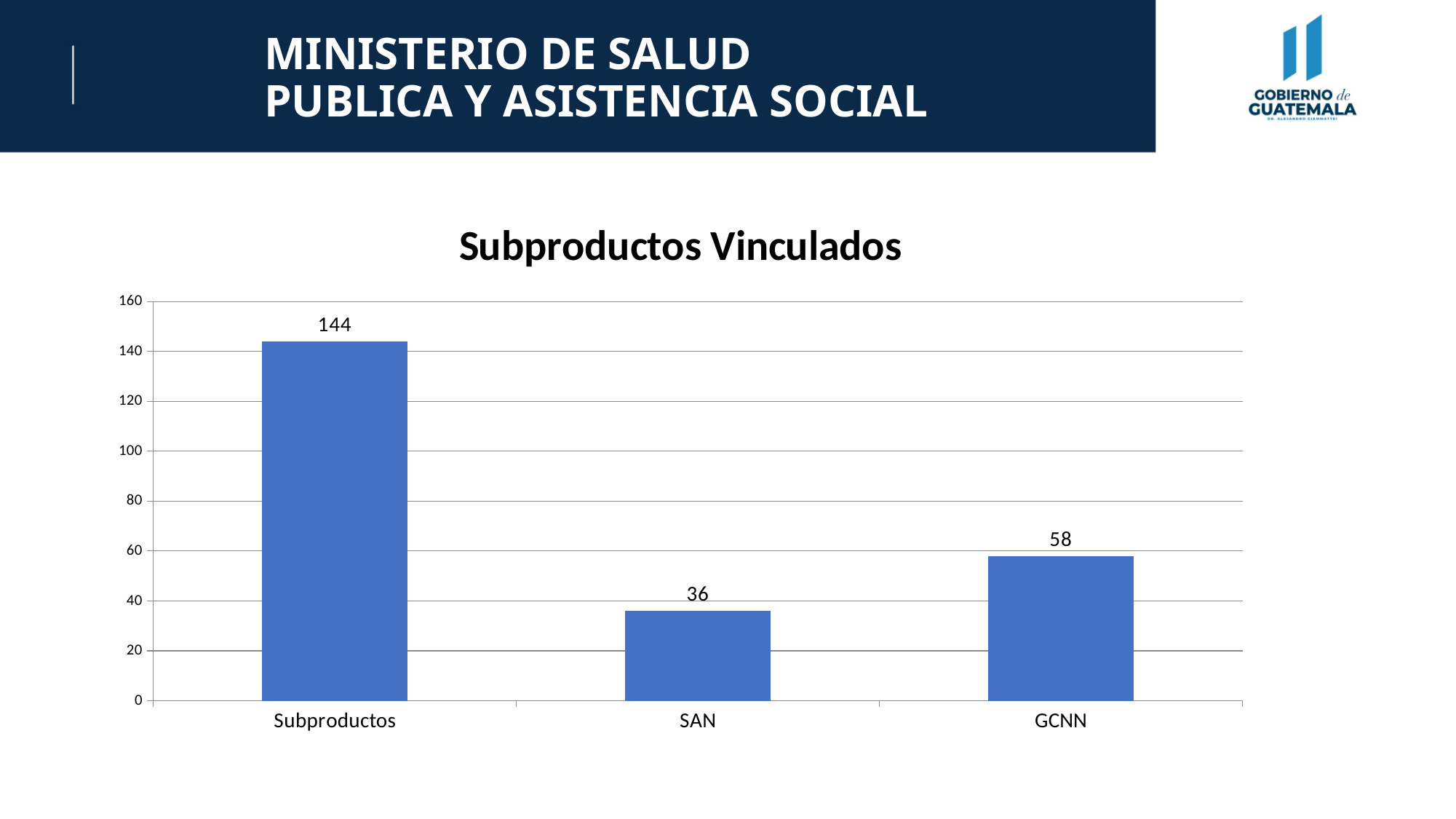
How many categories are shown on the x axis? 3 What is the difference between the values for GCNN and SAN? 22 Which category has the lowest value? SAN What is the value for SAN? 36 What is the value for Subproductos? 144 What is the value for GCNN? 58 What kind of chart is shown on the slide? bar chart Which category has the highest value? Subproductos Is the value for Subproductos greater or less than 100? greater What is the title of the chart? Subproductos Vinculados What is the difference between the values for Subproductos and GCNN? 86 Which is larger, the value for SAN or the value for GCNN? GCNN